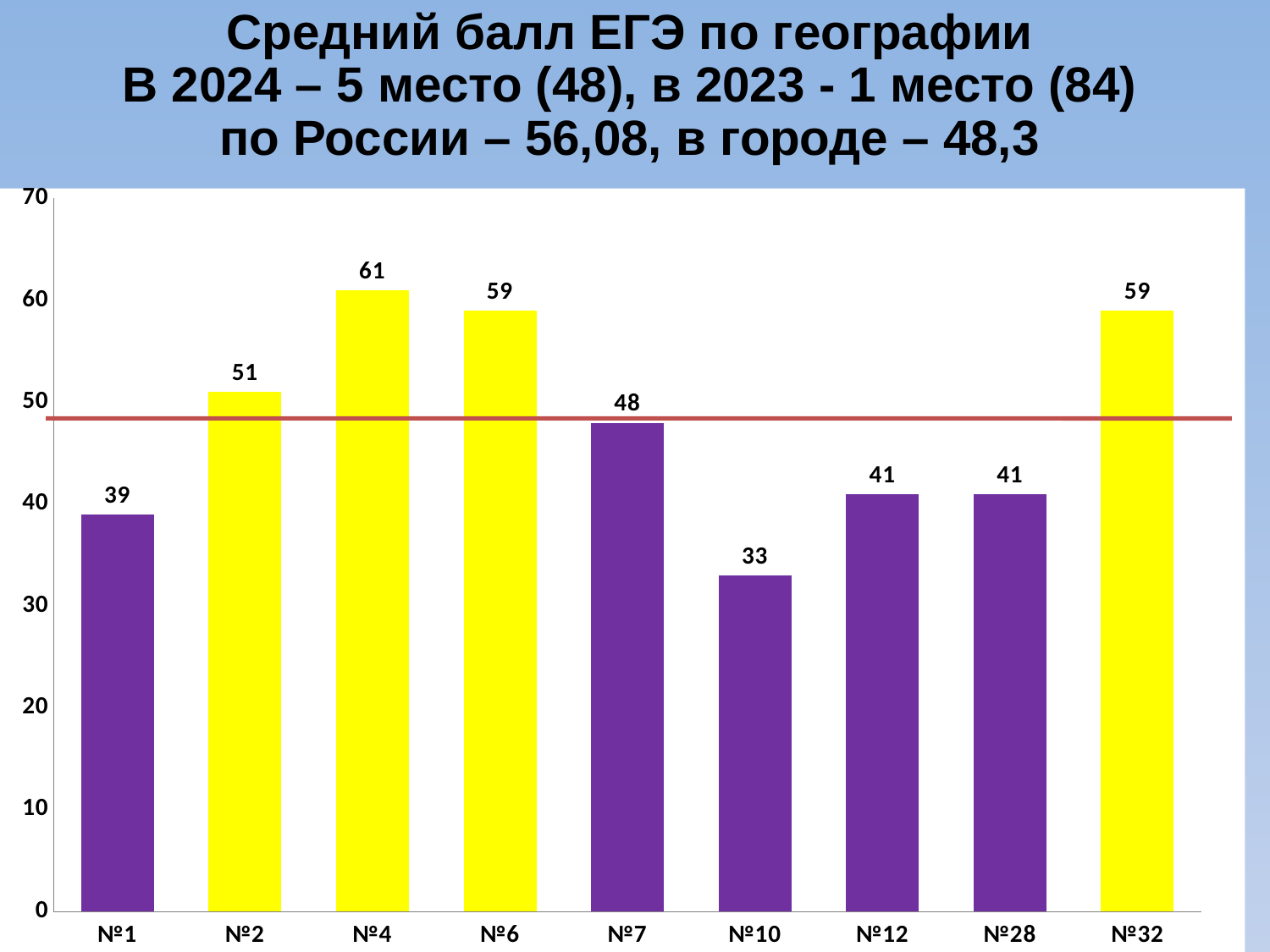
Which is larger, the value for №2 or the value for №12? №2 Which category has the lowest value? №10 What is the value for №10? 33 What colour are the bars for №2, №4, №6 and №32? yellow What is the value for №7? 48 What is the difference between the values for №32 and №28? 18 How many categories are shown on the x axis? 9 What kind of chart is shown on the slide? bar chart What is the difference between the values for №4 and №1? 22 Is the value for №6 greater or less than 50? greater Which category has the highest value? №4 What is the value for №4? 61